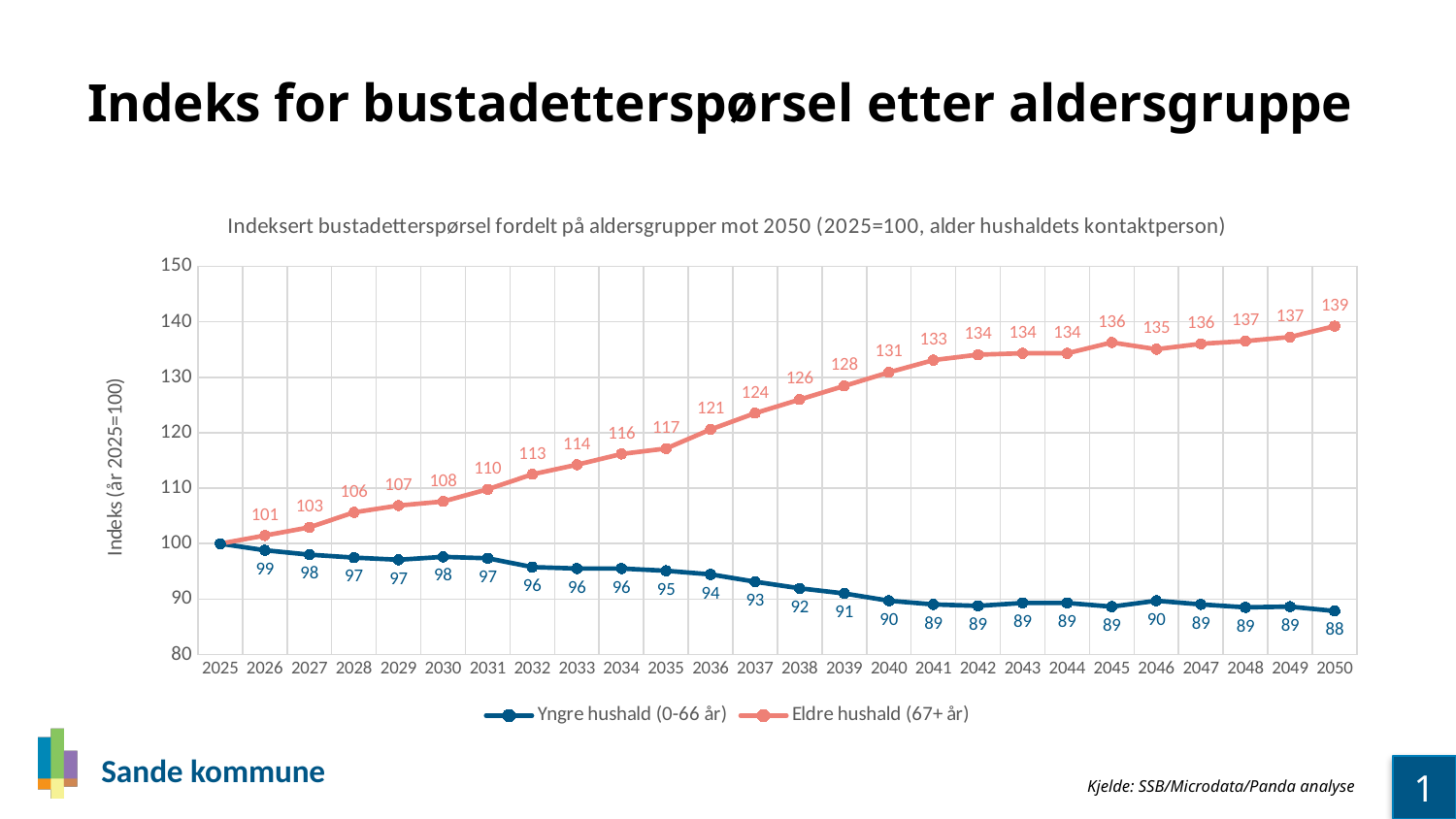
How many series does the legend list? 2 How many years are plotted on the x axis? 26 What kind of chart is shown on the slide? line chart What is the value for Eldre hushald (67+ år) in 2036? 121 What is the difference between Eldre hushald (67+ år) and Yngre hushald (0-66 år) in 2050? 51 What is the value for Yngre hushald (0-66 år) in 2040? 90 Is the value for Eldre hushald (67+ år) in 2040 greater or less than 120? greater Which series has the higher value in 2035, Yngre hushald (0-66 år) or Eldre hushald (67+ år)? Eldre hushald (67+ år) In which year does Eldre hushald (67+ år) reach its highest value? 2050 Does the value for Yngre hushald (0-66 år) rise or fall from 2025 to 2050? fall What is the value for Eldre hushald (67+ år) in 2050? 139 In which year does Yngre hushald (0-66 år) reach its lowest value? 2050